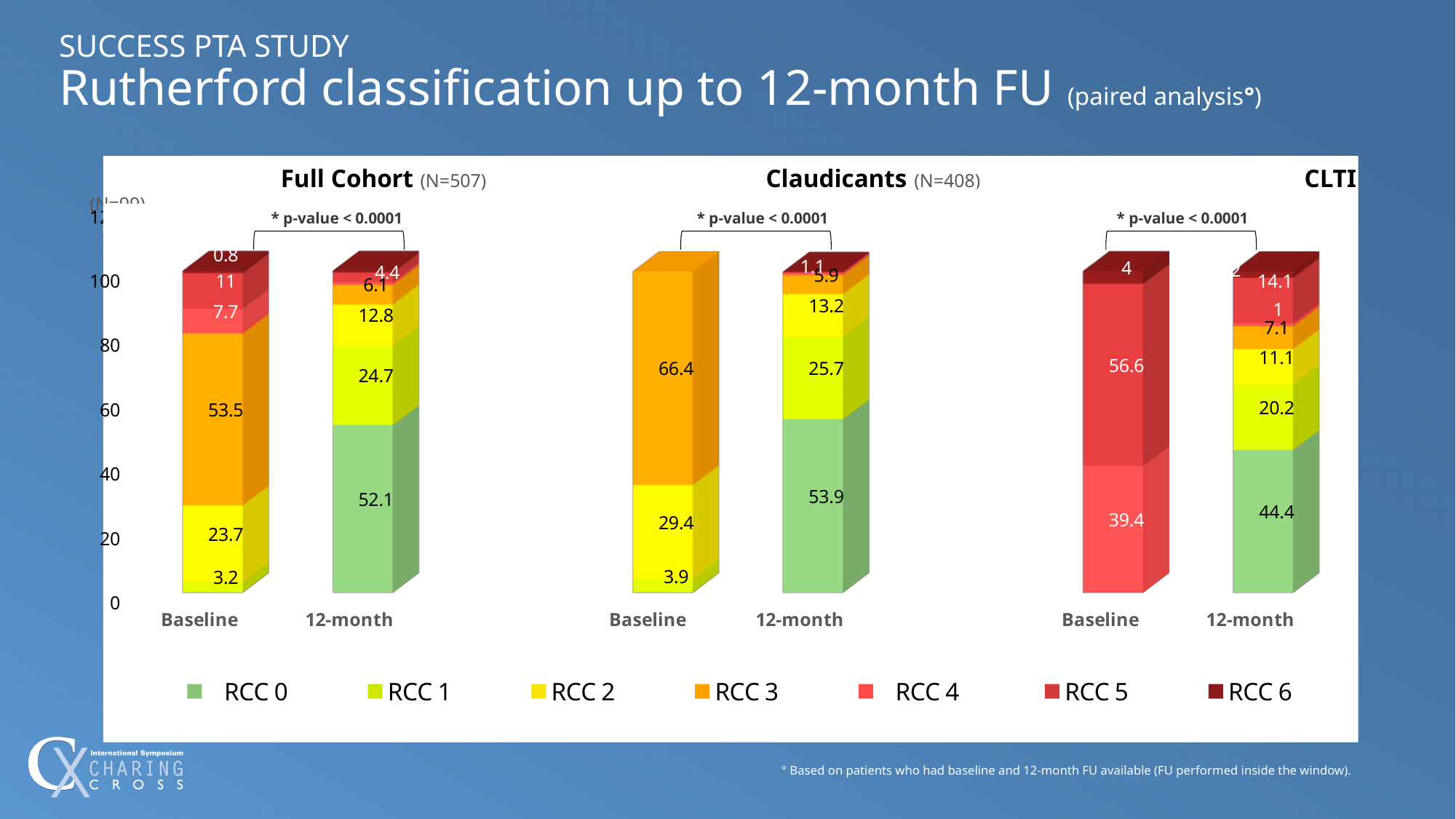
What is the N shown for the Claudicants group? N=408 What is the total of the CLTI Baseline stacked bar (39.4 + 56.6 + 4)? 100 Which is larger: the RCC 0 value at 12-month in the Full Cohort group or in the CLTI group? Full Cohort In the CLTI group, what is the value of the RCC 5 segment at Baseline? 56.6 In the CLTI group, what is the value of the RCC 0 segment at 12-month? 44.4 What kind of chart is shown on the slide? Stacked bar chart Which segment is the largest in the Claudicants Baseline bar? RCC 3 How many series does the legend list? 7 In the Full Cohort group, what is the value of the RCC 0 segment at 12-month? 52.1 In the Claudicants group, what is the value of the RCC 3 segment at Baseline? 66.4 In the Full Cohort group, what is the value of the RCC 3 segment at Baseline? 53.5 What is the difference between the RCC 3 Baseline value in the Claudicants group (66.4) and in the Full Cohort group (53.5)? 12.9